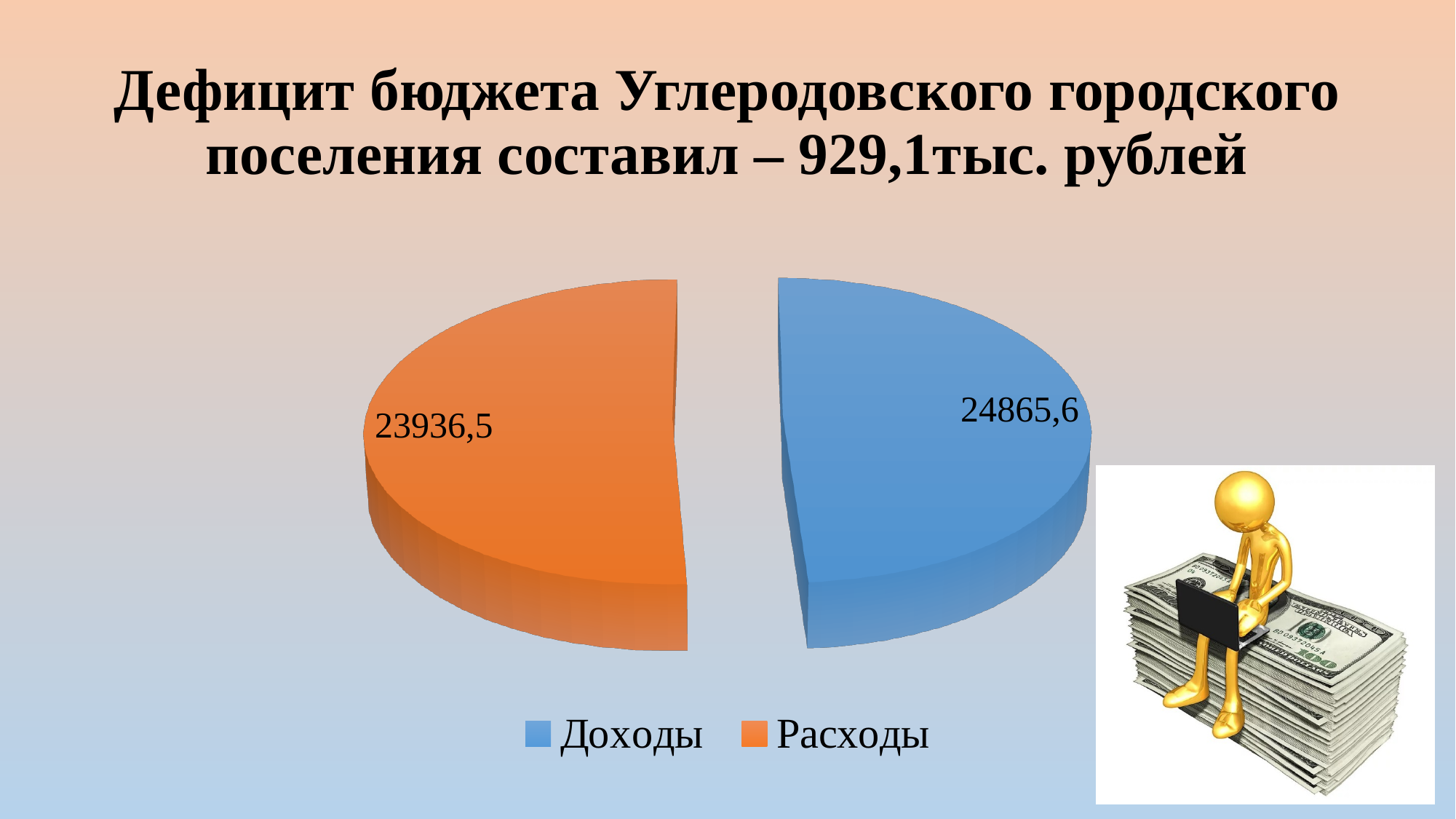
How many entries does the legend of the pie chart list? 2 Which slice of the pie chart has the smaller value? Расходы What is the difference between the values of the two slices of the pie chart? 929,1 What value is shown on the blue slice (Доходы) of the pie chart? 24865,6 Which colour represents Расходы in the pie chart legend? orange What is the total of the two values shown on the pie chart? 48802,1 Which slice of the pie chart has the larger value? Доходы How many slices does the pie chart have? 2 What kind of chart is shown on the slide? pie chart What are the two legend entries of the pie chart? Доходы, Расходы Is the value labelled 24865,6 larger or smaller than the value labelled 23936,5? larger What value is shown on the orange slice (Расходы) of the pie chart? 23936,5